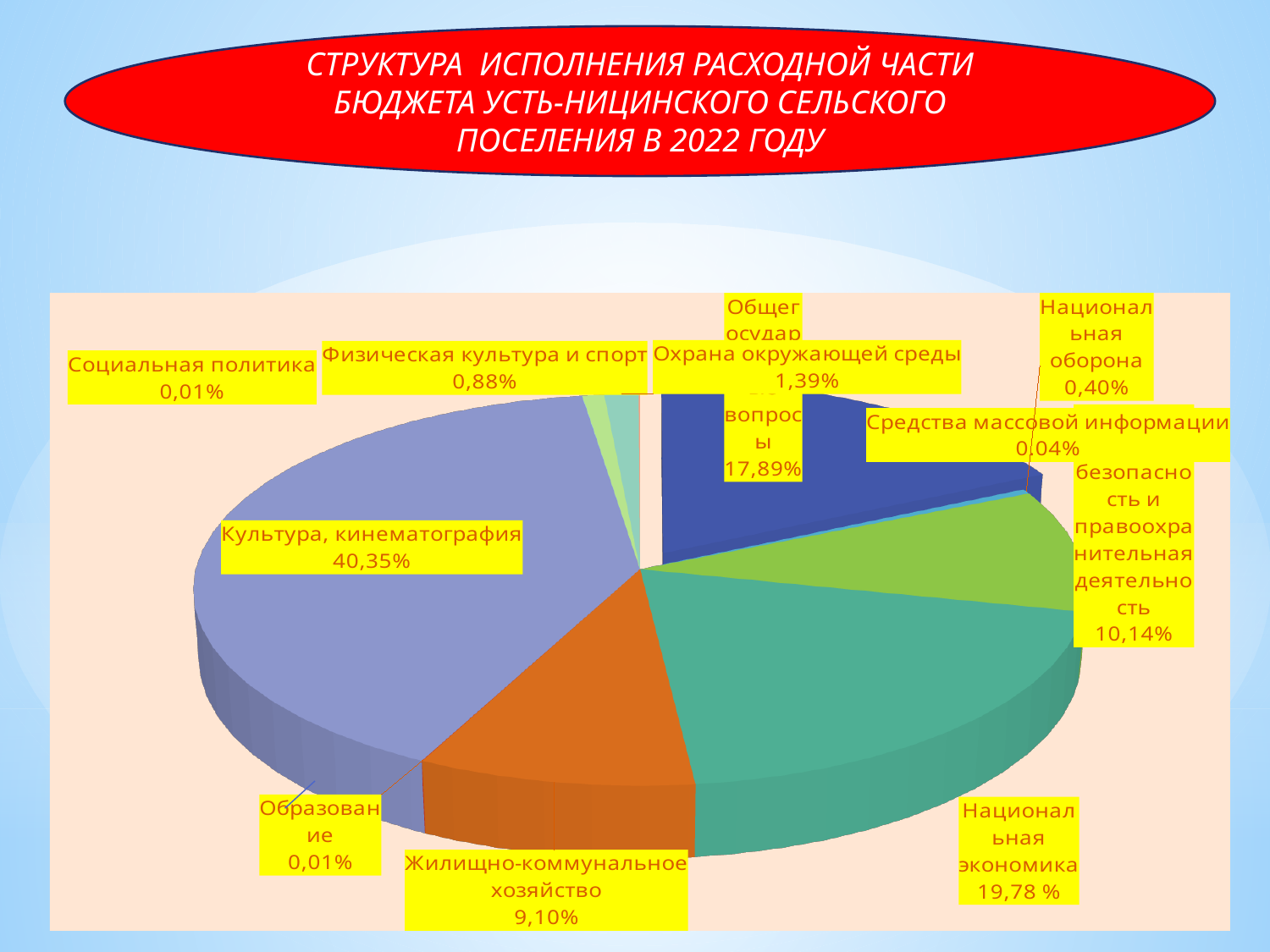
What is the value shown for Физическая культура и спорт? 0,88% What is the value shown for Средства массовой информации? 0,04% What is the value shown for Жилищно-коммунальное хозяйство? 9,10% Which category has the largest slice of the pie? Культура, кинематография What is the value shown for Национальная экономика? 19,78 % What is the difference between the shares of Культура, кинематография and Национальная экономика? 20,57% What is the value shown for Охрана окружающей среды? 1,39% How many categories are shown in the pie chart? 11 What kind of chart is shown on the slide? pie chart What is the value shown for Национальная оборона? 0,40% Which is larger: Национальная экономика or Общегосударственные вопросы? Национальная экономика What share of the pie does Культура, кинематография have? 40,35%